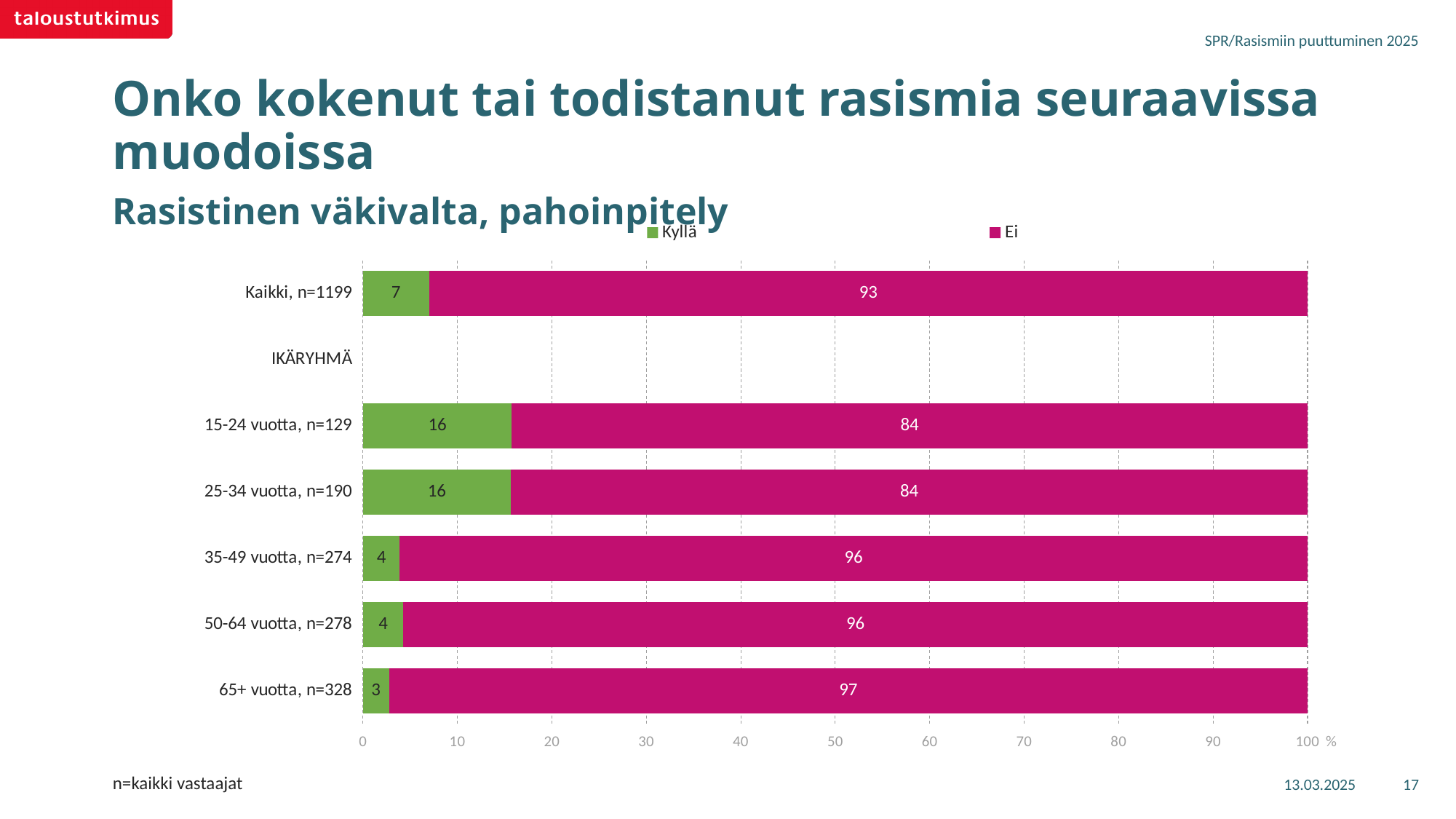
What colour represents the Ei series? Magenta What is the total of the stacked bar for 50-64 vuotta, n=278? 100 What is the difference between the Kyllä value for 15-24 vuotta, n=129 and the Kyllä value for Kaikki, n=1199? 9 What is the Kyllä value for Kaikki, n=1199? 7 What is the Kyllä value for 25-34 vuotta, n=190? 16 What is the Ei value for 65+ vuotta, n=328? 97 How many series does the legend list? 2 Which age group has the highest Ei value? 65+ vuotta, n=328 Which is larger: the Kyllä value for 15-24 vuotta, n=129 or the Kyllä value for 50-64 vuotta, n=278? 15-24 vuotta, n=129 What is the Ei value for 35-49 vuotta, n=274? 96 What kind of chart is shown on the slide? Stacked bar chart Which age group has the lowest Kyllä value? 65+ vuotta, n=328